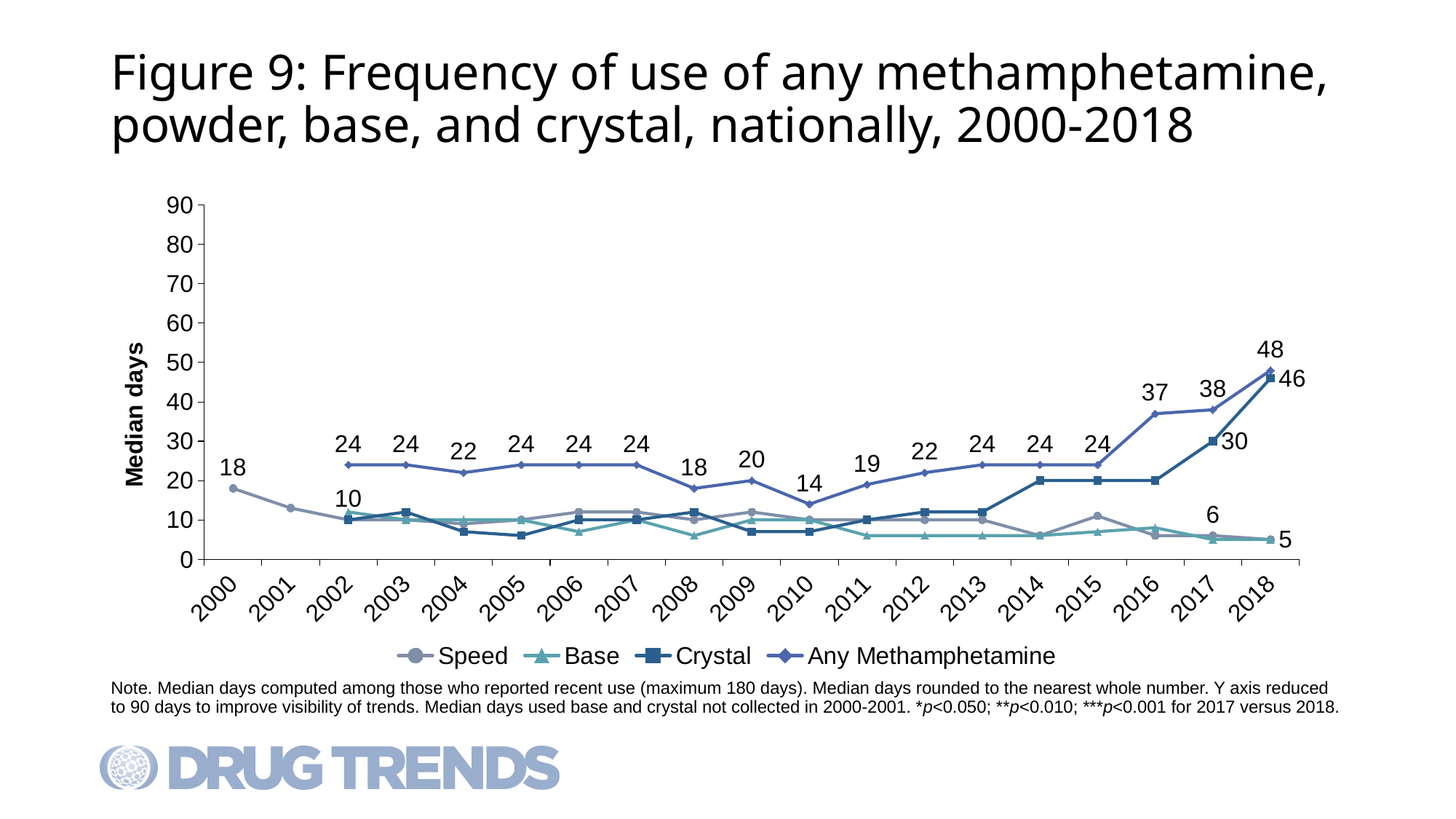
What type of chart is shown on the slide? line chart What is the median days value for Crystal in 2017? 30 How many years are shown on the x axis? 19 In which year is the Any Methamphetamine series highest? 2018 What is the median days value for Crystal in 2018? 46 Is the value for Crystal in 2014 greater or less than 10? greater What is the median days value for Any Methamphetamine in 2010? 14 What is the difference between the Any Methamphetamine values for 2018 and 2017? 10 How many series does the legend list? 4 What is the label on the y axis? Median days What is the median days value for Any Methamphetamine in 2016? 37 What is the median days value for Any Methamphetamine in 2018? 48